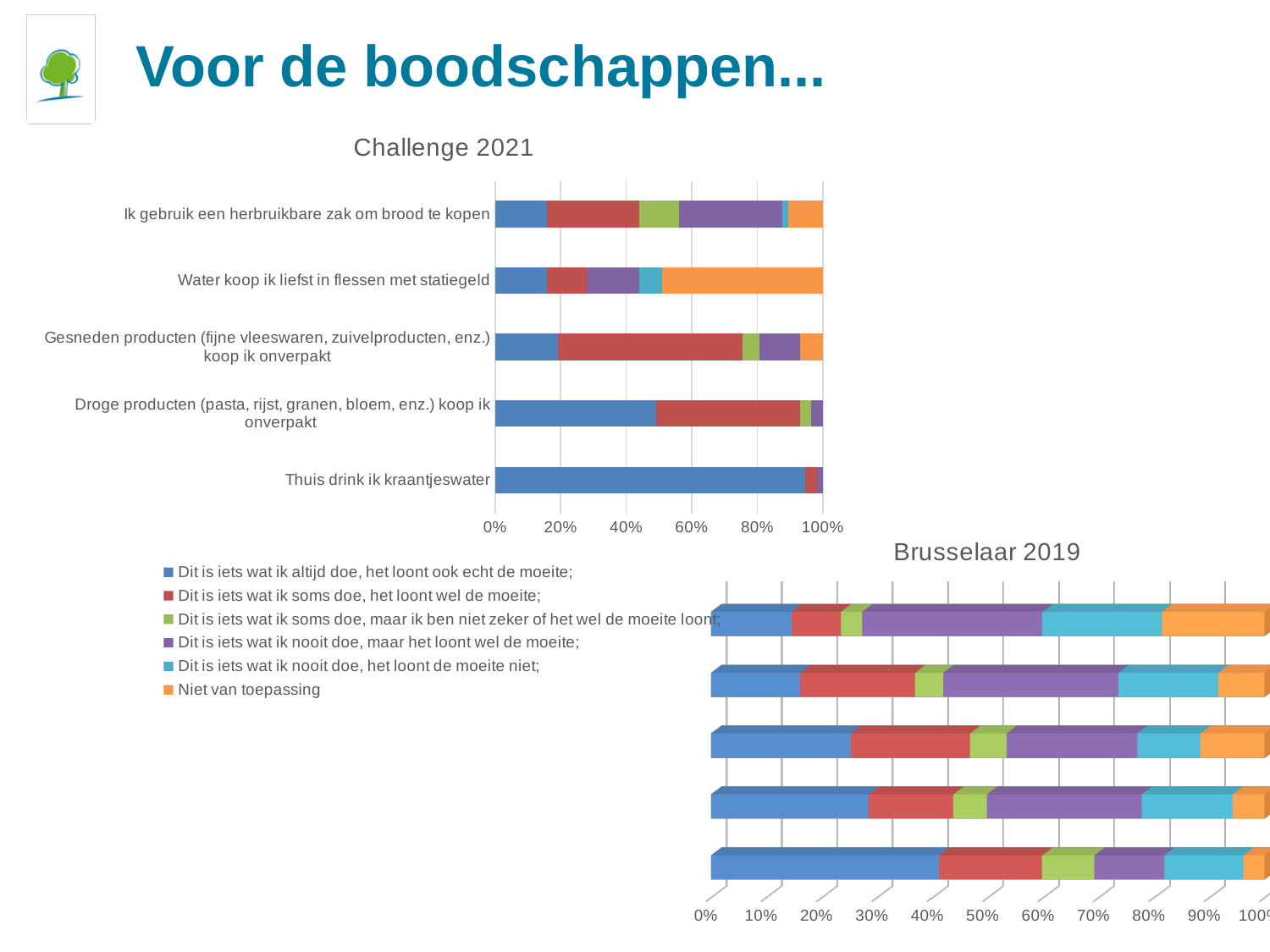
In the "Challenge 2021" chart, which category has the largest "Niet van toepassing" segment? Water koop ik liefst in flessen met statiegeld How many categories are shown on the "Challenge 2021" chart? 5 In the "Challenge 2021" chart, which has the larger "Dit is iets wat ik altijd doe, het loont ook echt de moeite" segment: "Thuis drink ik kraantjeswater" or "Droge producten (pasta, rijst, granen, bloem, enz.) koop ik onverpakt"? Thuis drink ik kraantjeswater How many bars are shown on the "Brusselaar 2019" chart? 5 What kind of chart is the "Challenge 2021" chart? Stacked bar chart What kind of chart is the "Brusselaar 2019" chart? Stacked bar chart In the "Challenge 2021" chart, which colour represents "Niet van toepassing"? Orange In the "Challenge 2021" chart, is the "Dit is iets wat ik altijd doe, het loont ook echt de moeite" segment for "Ik gebruik een herbruikbare zak om brood te kopen" greater or less than 20%? less In the "Challenge 2021" chart, is the "Niet van toepassing" segment for "Water koop ik liefst in flessen met statiegeld" greater or less than 40%? greater In the "Challenge 2021" chart, is the "Dit is iets wat ik altijd doe, het loont ook echt de moeite" segment for "Thuis drink ik kraantjeswater" greater or less than 80%? greater In the "Challenge 2021" chart, which category has the largest segment for "Dit is iets wat ik altijd doe, het loont ook echt de moeite"? Thuis drink ik kraantjeswater How many series does the legend of the "Challenge 2021" chart list? 6